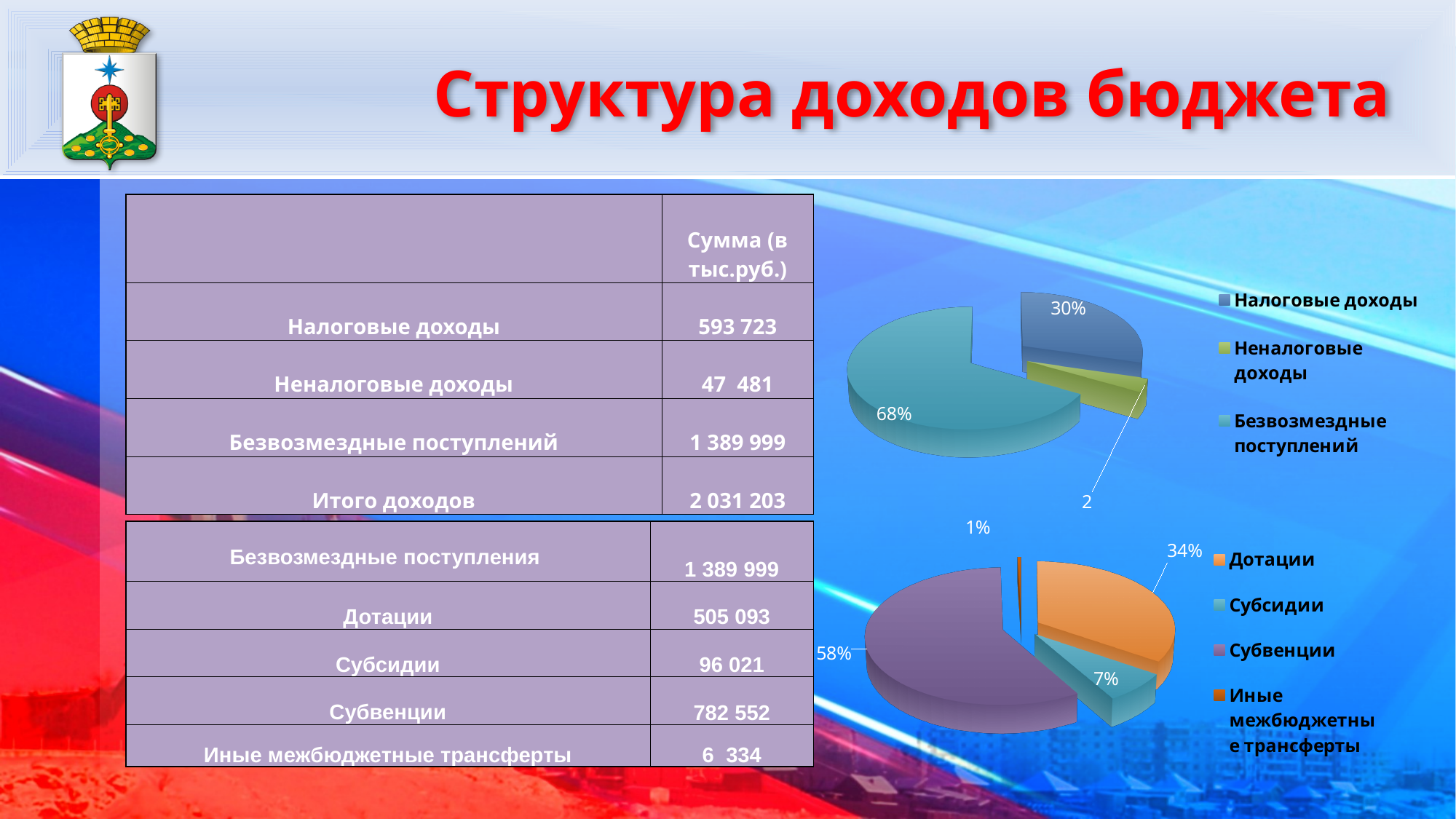
In the top pie chart, what share is shown for Безвозмездные поступлений? 68% In the bottom pie chart, what share is shown for Иные межбюджетные трансферты? 1% In the bottom pie chart, which category has the largest slice? Субвенции In the bottom pie chart, what share is shown for Субвенции? 58% What type of charts are shown on the slide? Pie charts In the top pie chart, which category has the largest slice? Безвозмездные поступлений How many categories does the legend of the top pie chart list? 3 In the bottom pie chart, what is the difference in percentage points between Субвенции and Дотации? 24 In the top pie chart, which category has the smallest slice? Неналоговые доходы